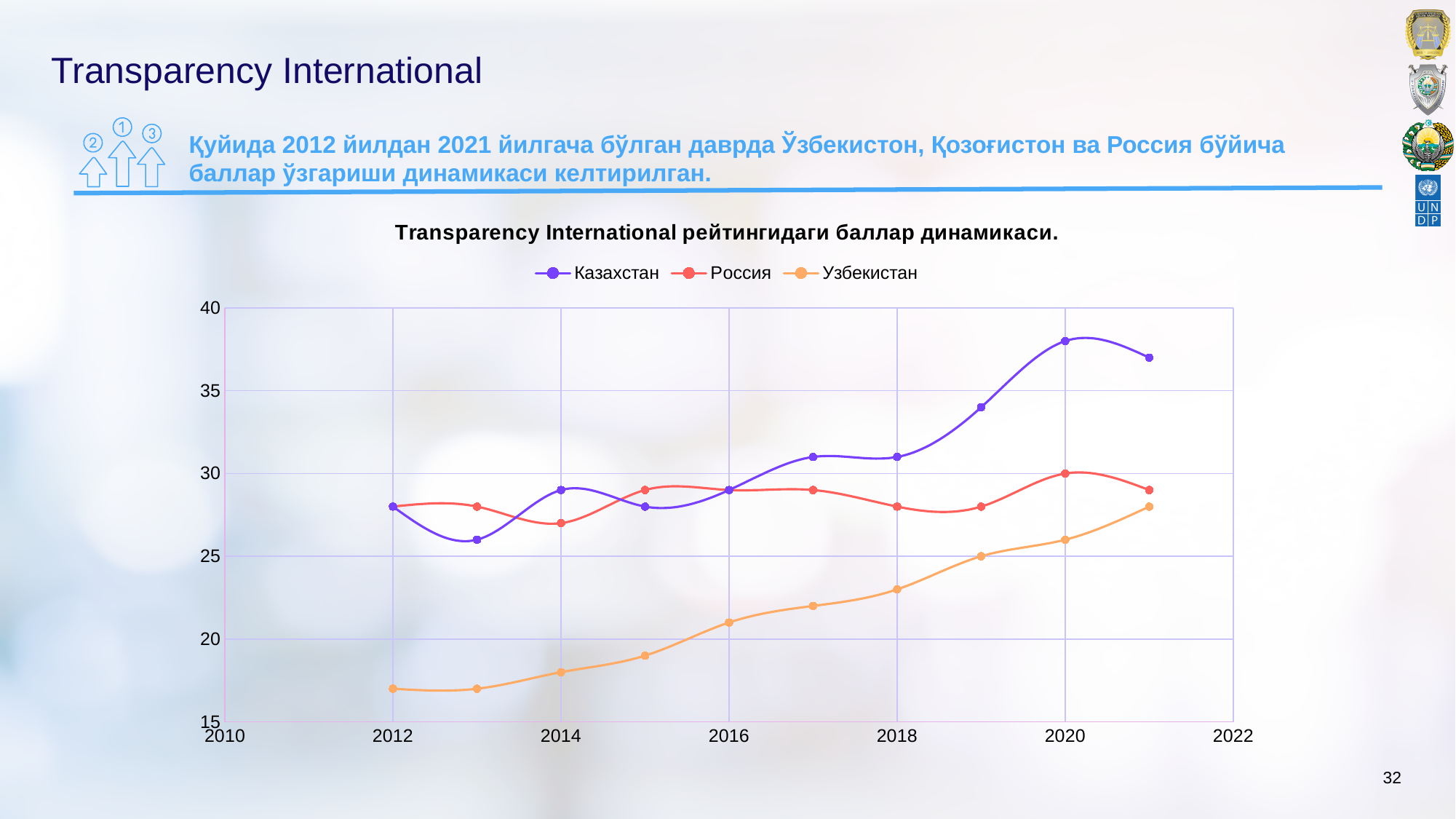
Is the value for Казахстан in 2020 greater or less than 35? greater Which series has the lowest value in 2021? Узбекистан Does the Узбекистан series rise or fall from 2012 to 2021? rise How many series does the legend list? 3 Which series has the highest value in 2020? Казахстан What is the value for Узбекистан in 2019? 25 What is the value for Россия in 2020? 30 What is the title of the chart? Transparency International рейтингидаги баллар динамикаси. What kind of chart is shown on the slide? line chart Is the value for Узбекистан in 2012 greater or less than 20? less How many data points does the Узбекистан series have? 10 Is the value for Россия in 2014 greater or less than 30? less